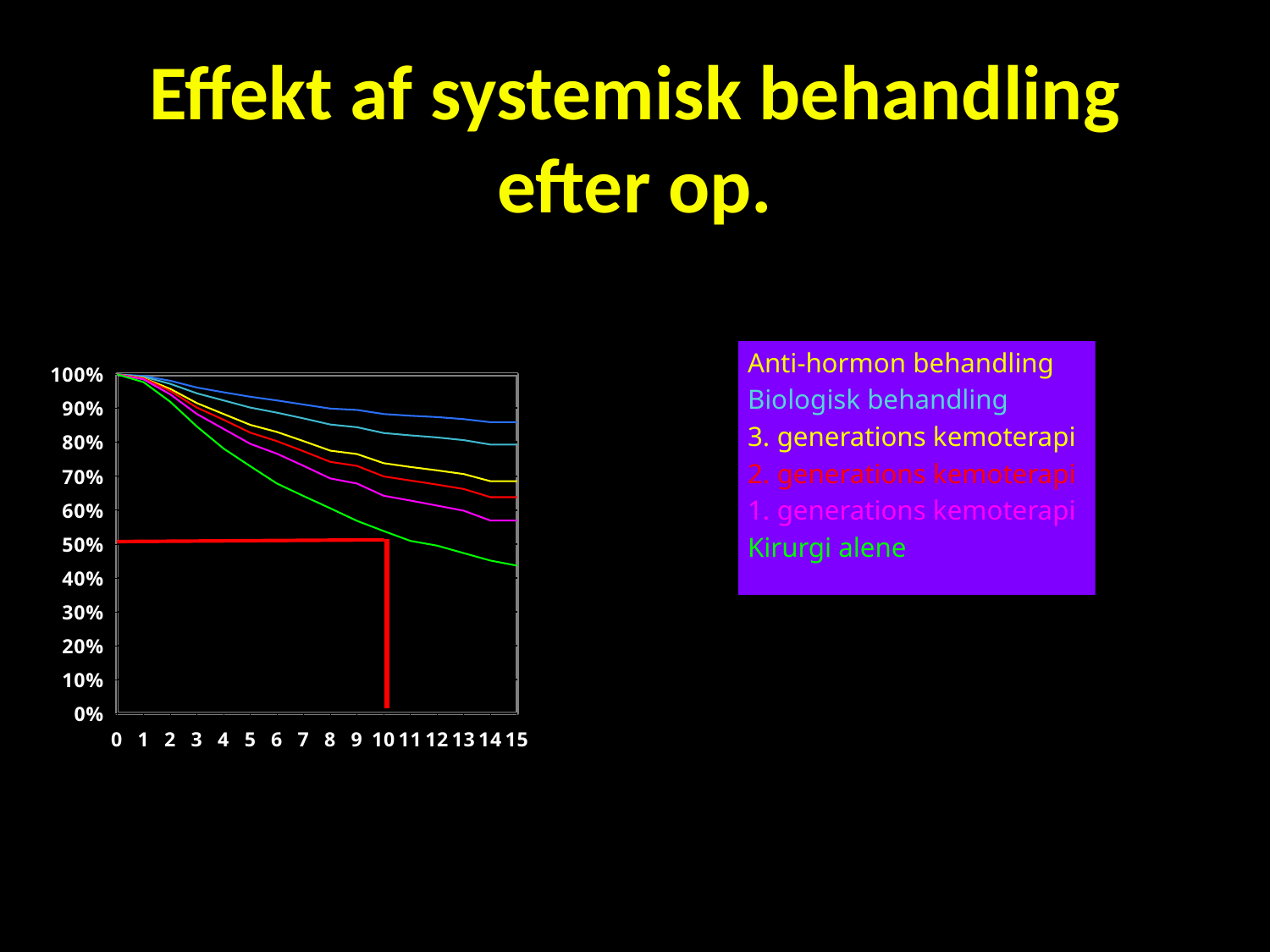
Is the value for Kirurgi alene at x = 15 greater or less than 50%? less How many series does the legend list? 6 Which series has the highest value at x = 15? Anti-hormon behandling How many points are labelled on the x axis of the chart? 16 What kind of chart is shown on the slide? line chart What is the value of all series at x = 0? 100% Which series has the lowest value at x = 15? Kirurgi alene Is the value for Anti-hormon behandling at x = 15 greater or less than 80%? greater What colour is the line for Kirurgi alene? green Do the lines rise or fall as the x axis goes from 0 to 15? fall At x = 15, which is larger: Anti-hormon behandling or Kirurgi alene? Anti-hormon behandling What is the title of the slide containing the chart? Effekt af systemisk behandling efter op.